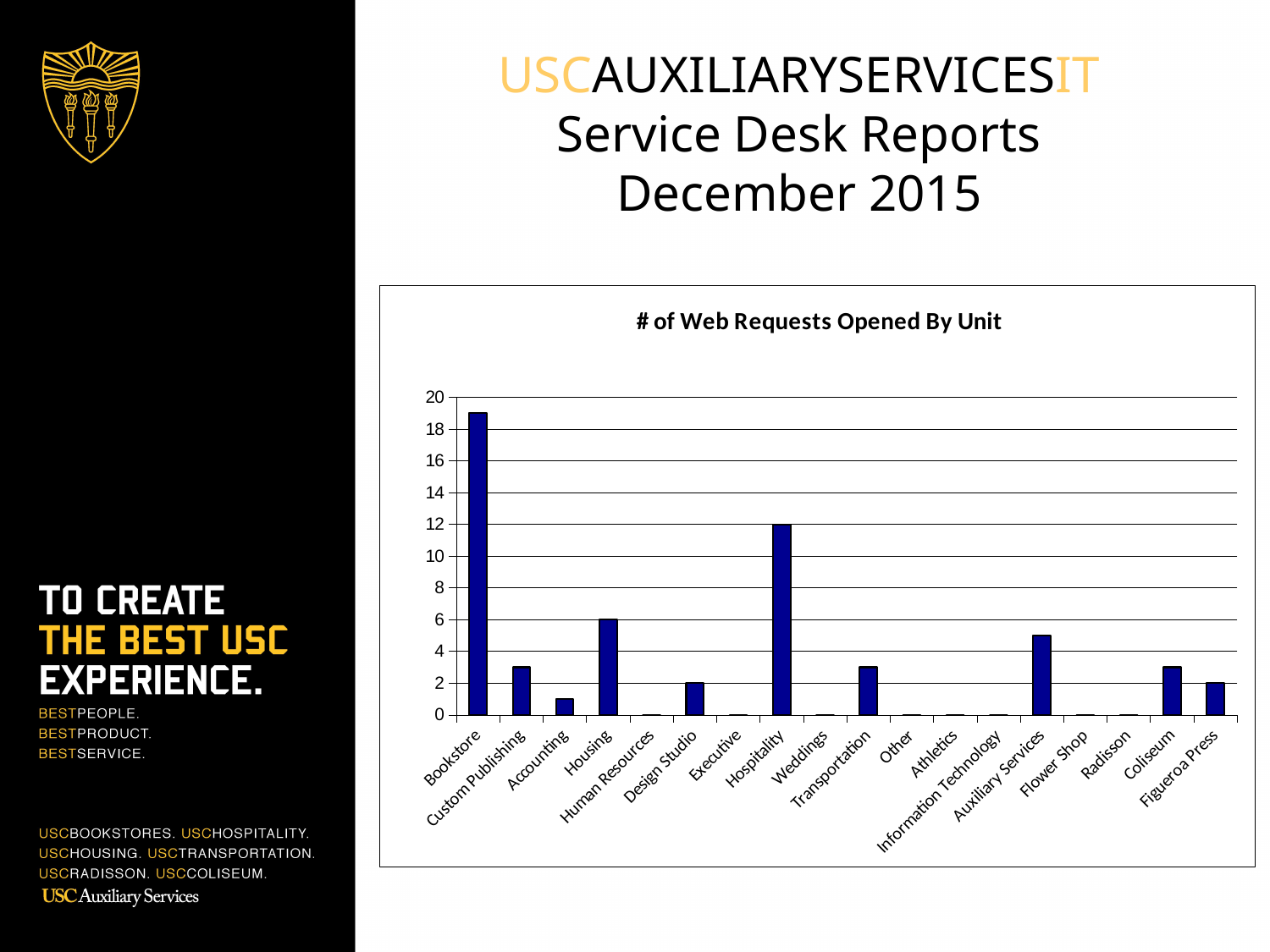
Which unit has the highest number of web requests opened? Bookstore How many web requests were opened by Design Studio? 2 Which has more web requests opened, Hospitality or Housing? Hospitality How many web requests were opened by Hospitality? 12 How many web requests were opened by Figueroa Press? 2 How many web requests were opened by Housing? 6 What is the title of the chart? # of Web Requests Opened By Unit Is the value for Accounting greater or less than 2? less Is the value for Bookstore greater or less than 18? greater What is the difference between the number of web requests opened by Hospitality and by Housing? 6 Is the value for Auxiliary Services greater or less than 4? greater What kind of chart is shown on the slide? Bar chart